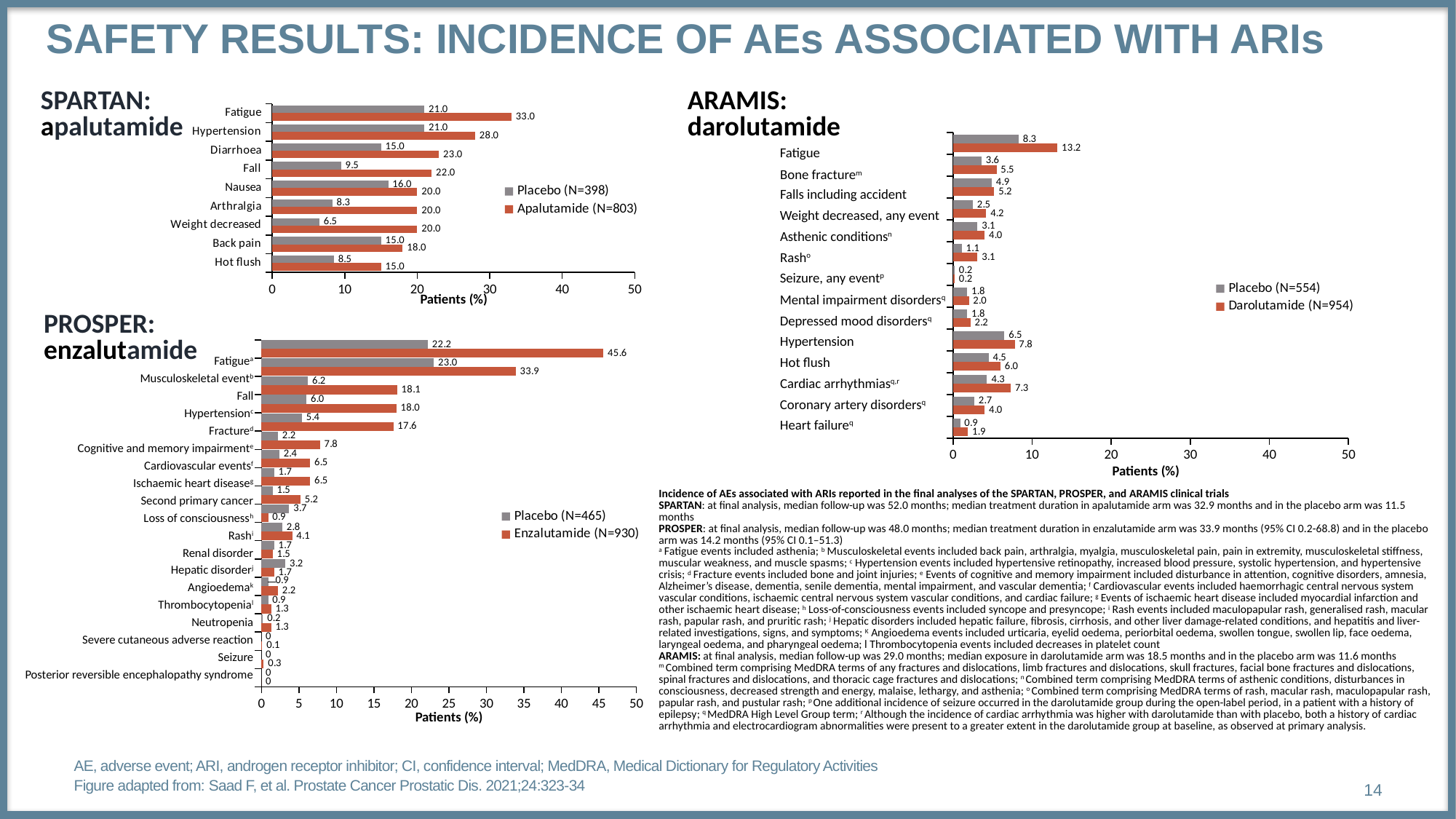
In the ARAMIS: darolutamide chart, which is larger for Hypertension: the Placebo value or the Darolutamide value? Darolutamide (N=954) In the ARAMIS: darolutamide chart, what is the Darolutamide (N=954) value for Cardiac arrhythmias? 7.3 What type of chart is the ARAMIS: darolutamide chart? Bar chart In the SPARTAN: apalutamide chart, what is the Placebo (N=398) value for Fall? 9.5 In the SPARTAN: apalutamide chart, what is the difference between the Apalutamide and Placebo values for Weight decreased? 13.5 In the PROSPER: enzalutamide chart, which category has the highest Enzalutamide (N=930) value? Fatigue How many series does the legend of the PROSPER: enzalutamide chart list? 2 In the ARAMIS: darolutamide chart, what is the difference between the Darolutamide and Placebo values for Fatigue? 4.9 How many categories are shown in the SPARTAN: apalutamide chart? 9 In the SPARTAN: apalutamide chart, which category has the lowest Placebo (N=398) value? Weight decreased In the PROSPER: enzalutamide chart, what is the Enzalutamide (N=930) value for Fatigue? 45.6 In the SPARTAN: apalutamide chart, what is the value for Fatigue in the Apalutamide (N=803) series? 33.0